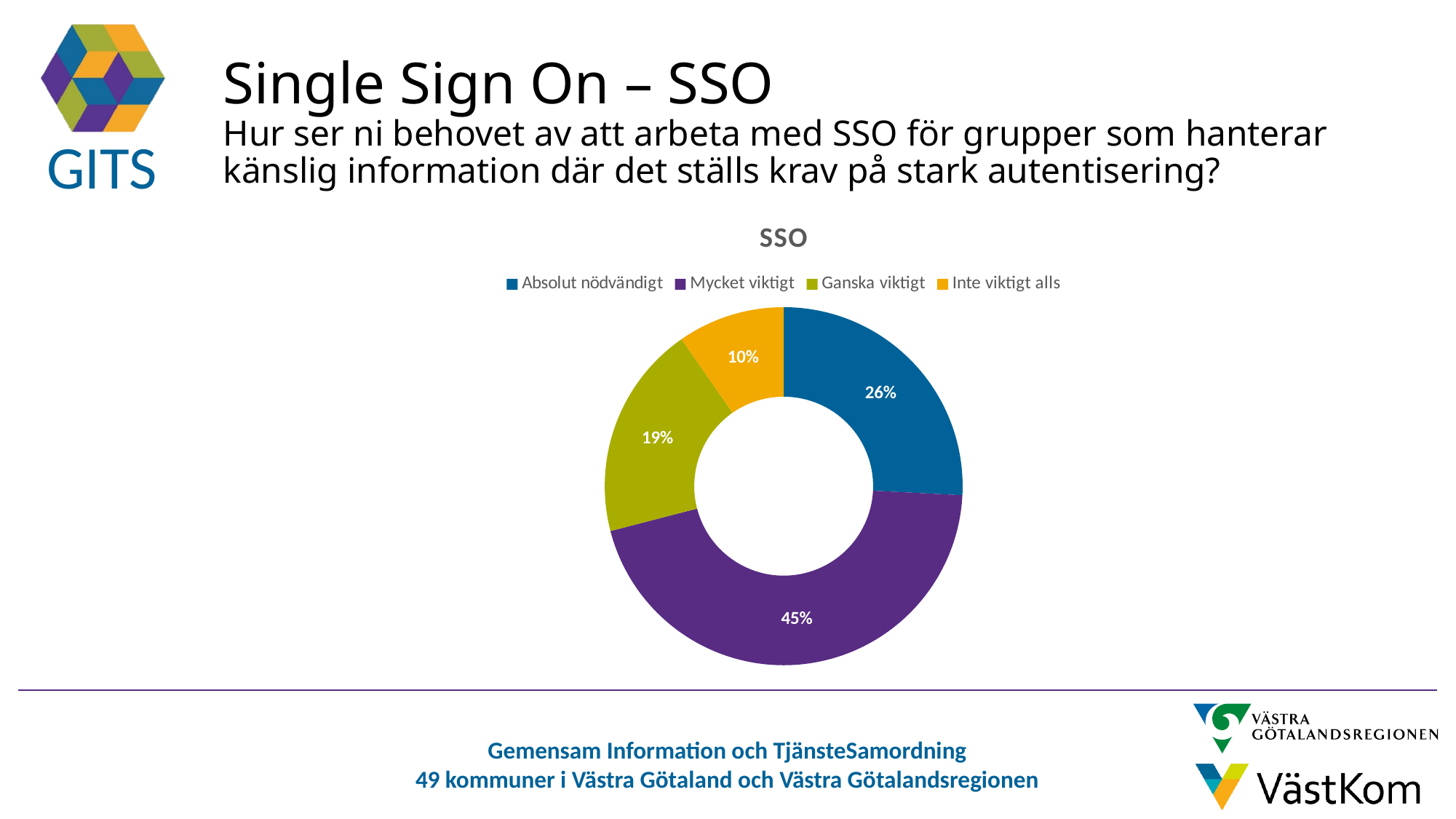
What percentage of the chart is 'Mycket viktigt'? 45% What percentage of the chart is 'Absolut nödvändigt'? 26% What is the difference in percentage points between 'Mycket viktigt' and 'Absolut nödvändigt'? 19 Which category has the largest share of the chart? Mycket viktigt Which category has the smallest share of the chart? Inte viktigt alls What is the title of the chart? SSO Which is larger, 'Ganska viktigt' or 'Inte viktigt alls'? Ganska viktigt What colour represents 'Inte viktigt alls' in the chart? Orange How many categories does the legend list? 4 What percentage of the chart is 'Inte viktigt alls'? 10% What type of chart is shown on the slide? Doughnut chart What percentage of the chart is 'Ganska viktigt'? 19%